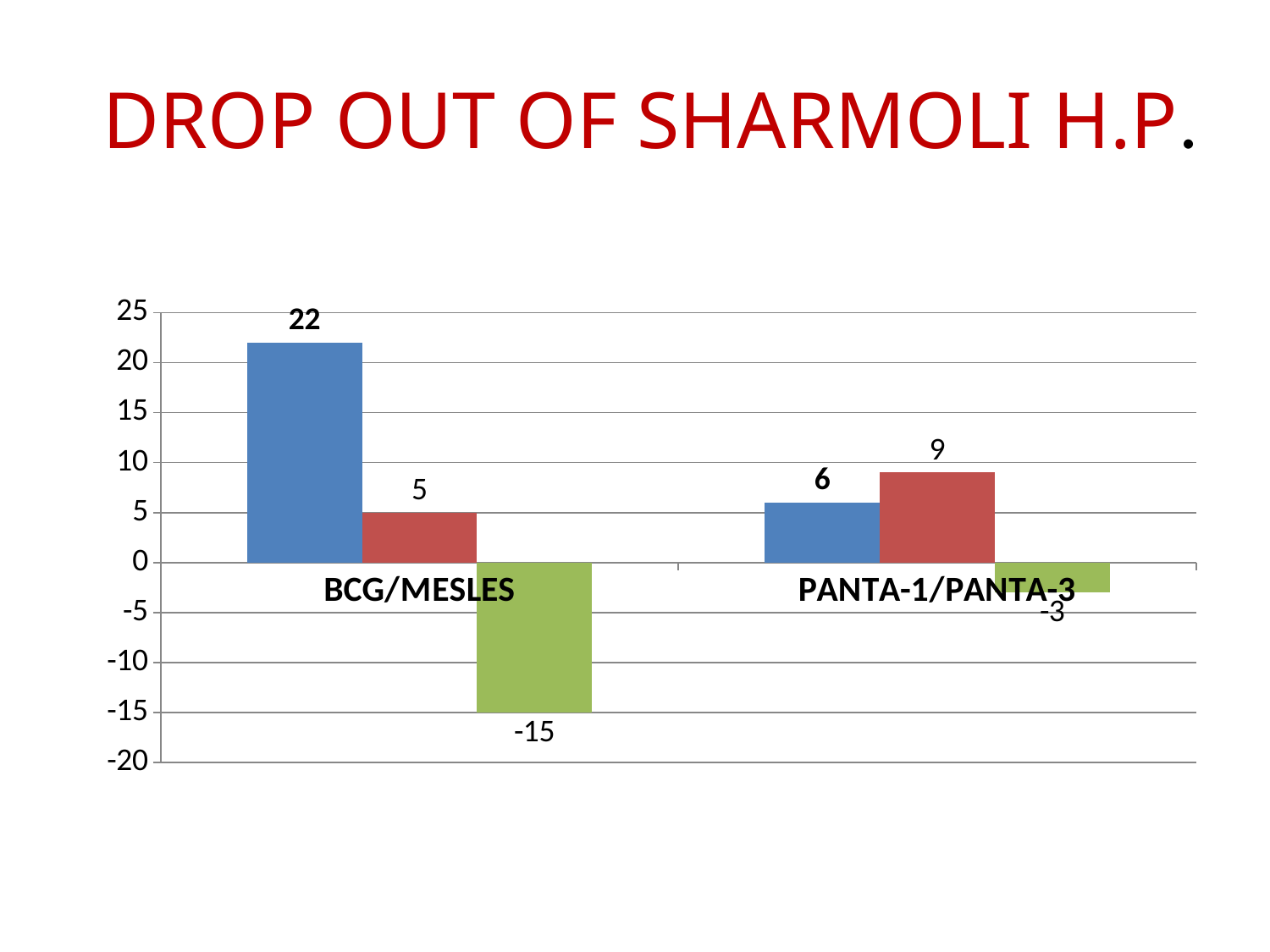
How many categories are shown on the x axis? 2 What is the title of the slide? DROP OUT OF SHARMOLI H.P. What is the difference between the red bar values for PANTA-1/PANTA-3 and BCG/MESLES? 4 What is the value of the red bar for PANTA-1/PANTA-3? 9 What is the value of the green bar for PANTA-1/PANTA-3? -3 For PANTA-1/PANTA-3, which is larger, the blue bar or the red bar? The red bar What type of chart is shown on the slide? Bar chart What is the value of the green bar for BCG/MESLES? -15 Which bar has the highest value on the chart? The blue bar for BCG/MESLES (22) Which bar has the lowest value on the chart? The green bar for BCG/MESLES (-15) What is the value of the blue bar for BCG/MESLES? 22 What is the difference between the blue bar values for BCG/MESLES and PANTA-1/PANTA-3? 16